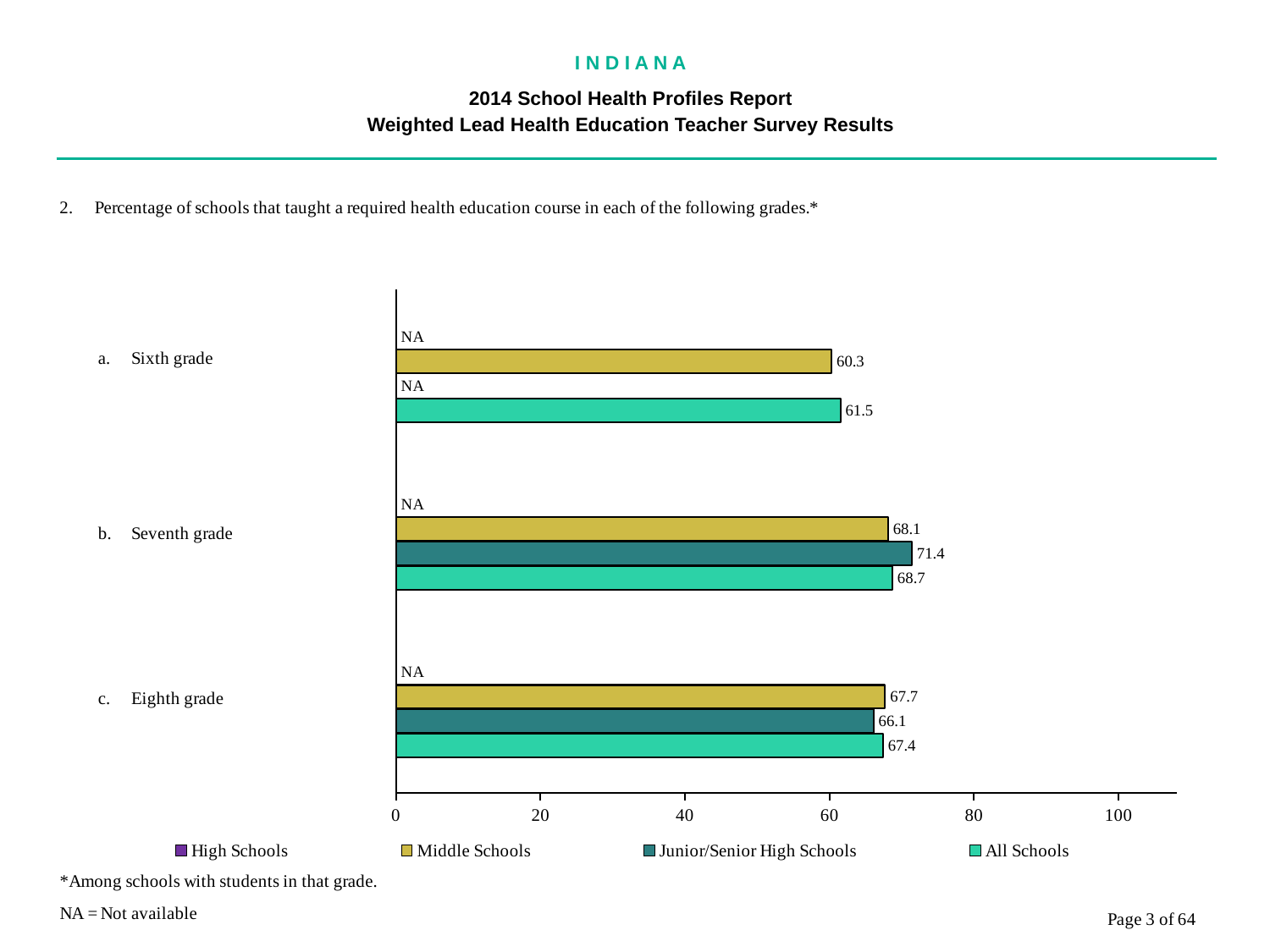
What is the difference between the Junior/Senior High Schools values for Seventh grade and Eighth grade? 5.3 What is the difference between the All Schools values for Seventh grade and Sixth grade? 7.2 Which grade has the lowest value for Middle Schools? Sixth grade What is the value for Junior/Senior High Schools in Seventh grade? 71.4 What is the value for All Schools in Eighth grade? 67.4 How many series does the legend list? 4 In Seventh grade, which is larger: the Middle Schools value or the Junior/Senior High Schools value? Junior/Senior High Schools What is the value for Middle Schools in Sixth grade? 60.3 Which grade has the highest value for All Schools? Seventh grade What kind of chart is shown on the slide? Bar chart What is shown for High Schools in Sixth grade? NA How many grade categories are shown on the chart? 3